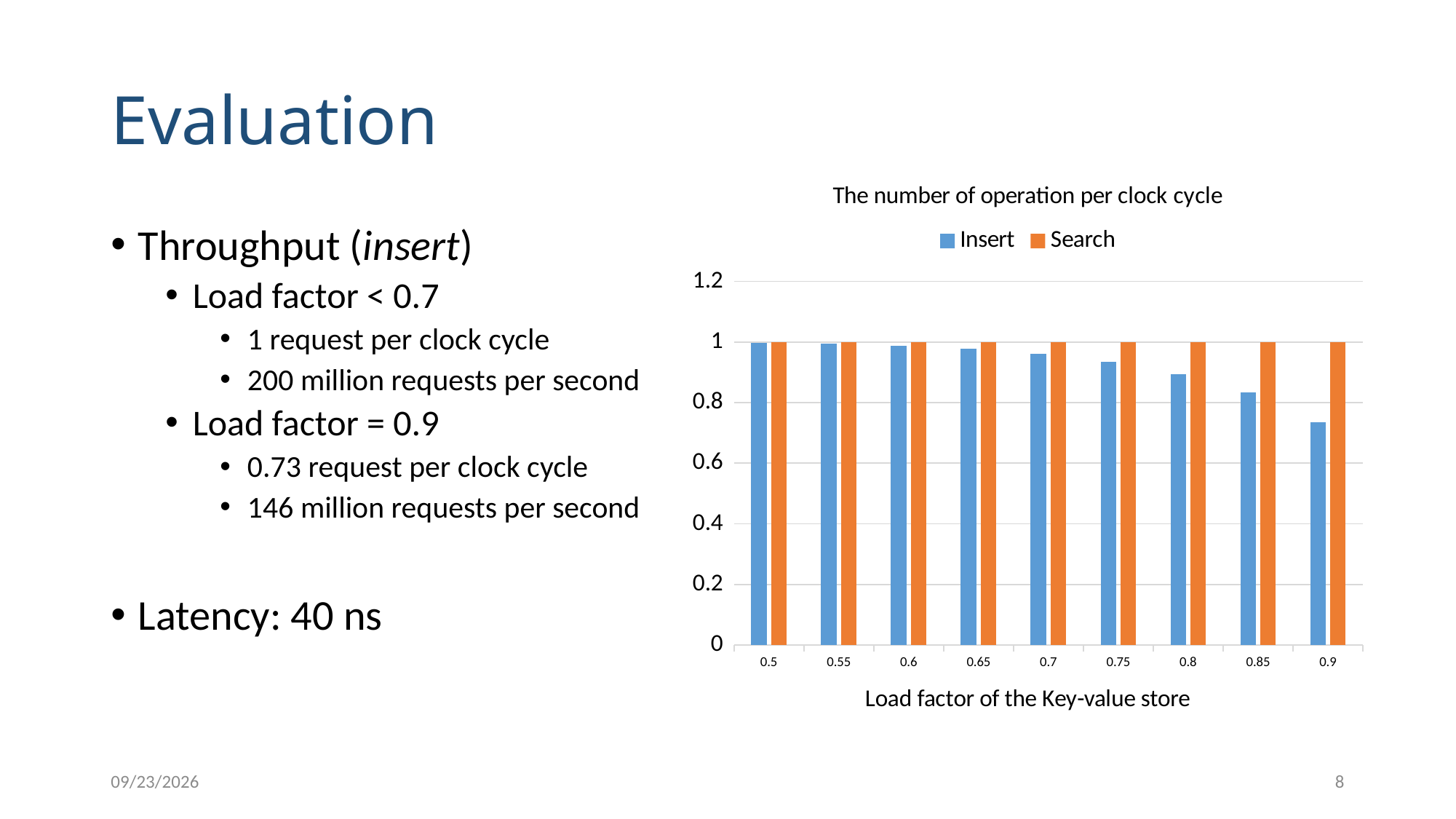
Is the Insert value at load factor 0.9 greater or less than 0.6? greater Which load factor has the lowest Insert value? 0.9 What is the title of the chart? The number of operation per clock cycle How many load factor categories are shown on the x axis of the chart? 9 Is the Insert value at load factor 0.85 greater or less than 0.8? greater What is the x-axis title of the chart? Load factor of the Key-value store Is the Insert value at load factor 0.9 greater or less than 0.8? less Do the Insert values rise or fall as the load factor increases along the x axis? fall What kind of chart is shown on the slide? bar chart How many series does the chart legend list? 2 At load factor 0.9, which is larger, the Insert value or the Search value? Search